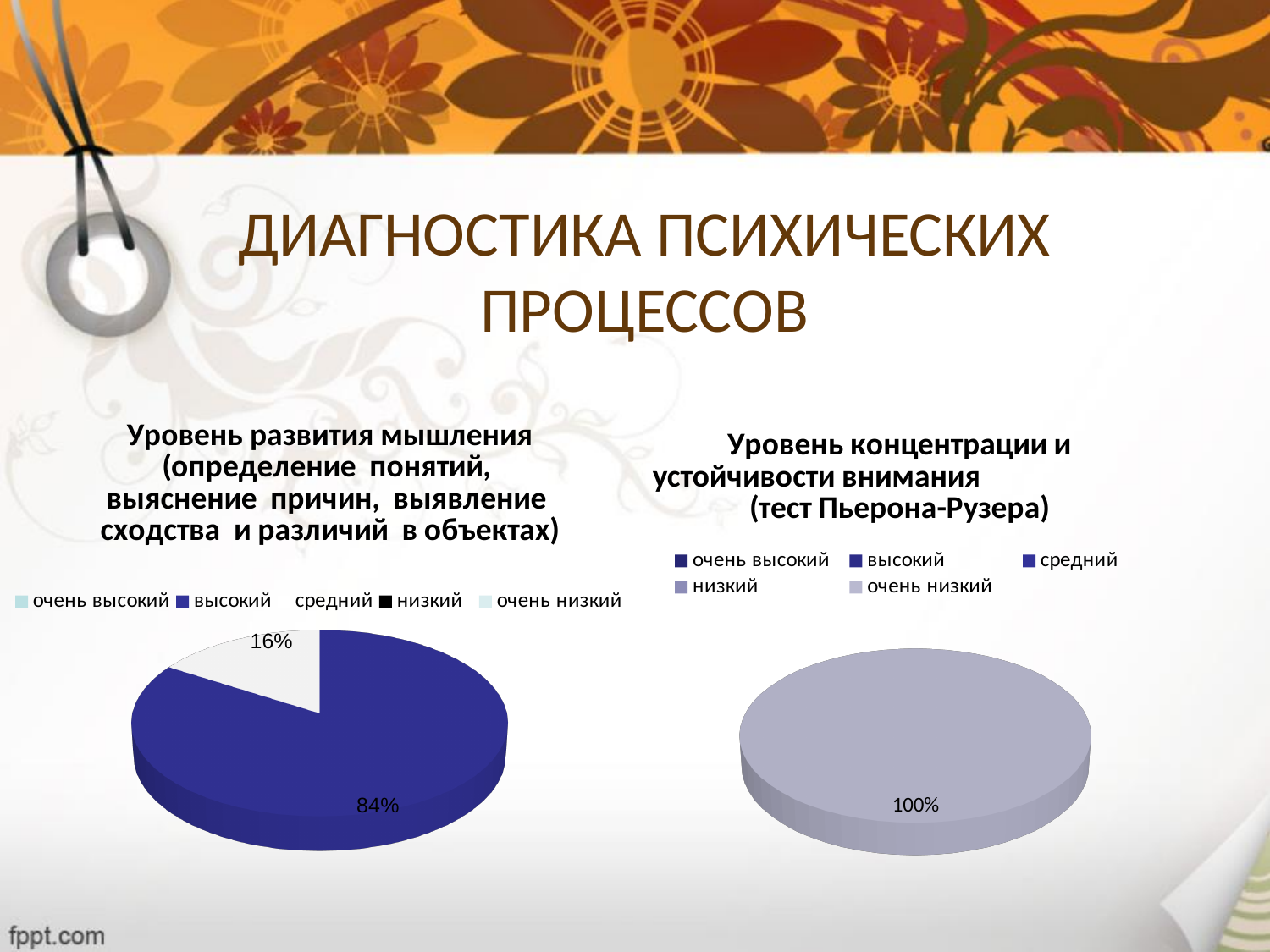
How many entries does the legend of the left chart, 'Уровень развития мышления', list? 5 How many entries does the legend of the right chart, 'Уровень концентрации и устойчивости внимания', list? 5 In the left chart, 'Уровень развития мышления', what is the value of the largest slice? 84% In the left chart, 'Уровень развития мышления', what is the difference between the two slices, 84% and 16%? 68 percentage points In the left chart, 'Уровень развития мышления', what is the value of the smallest slice? 16% In the right chart, 'Уровень концентрации и устойчивости внимания', what value is shown on the single slice? 100% What kind of chart is the left chart, 'Уровень развития мышления'? pie chart How many slices does the left chart, 'Уровень развития мышления', have? 2 In the left chart, 'Уровень развития мышления', which slice is larger, the blue one or the white one? the blue one What kind of chart is the right chart, 'Уровень концентрации и устойчивости внимания'? pie chart In the left chart, 'Уровень развития мышления', what share does the blue slice ('высокий') have? 84% How many slices does the right chart, 'Уровень концентрации и устойчивости внимания', have? 1